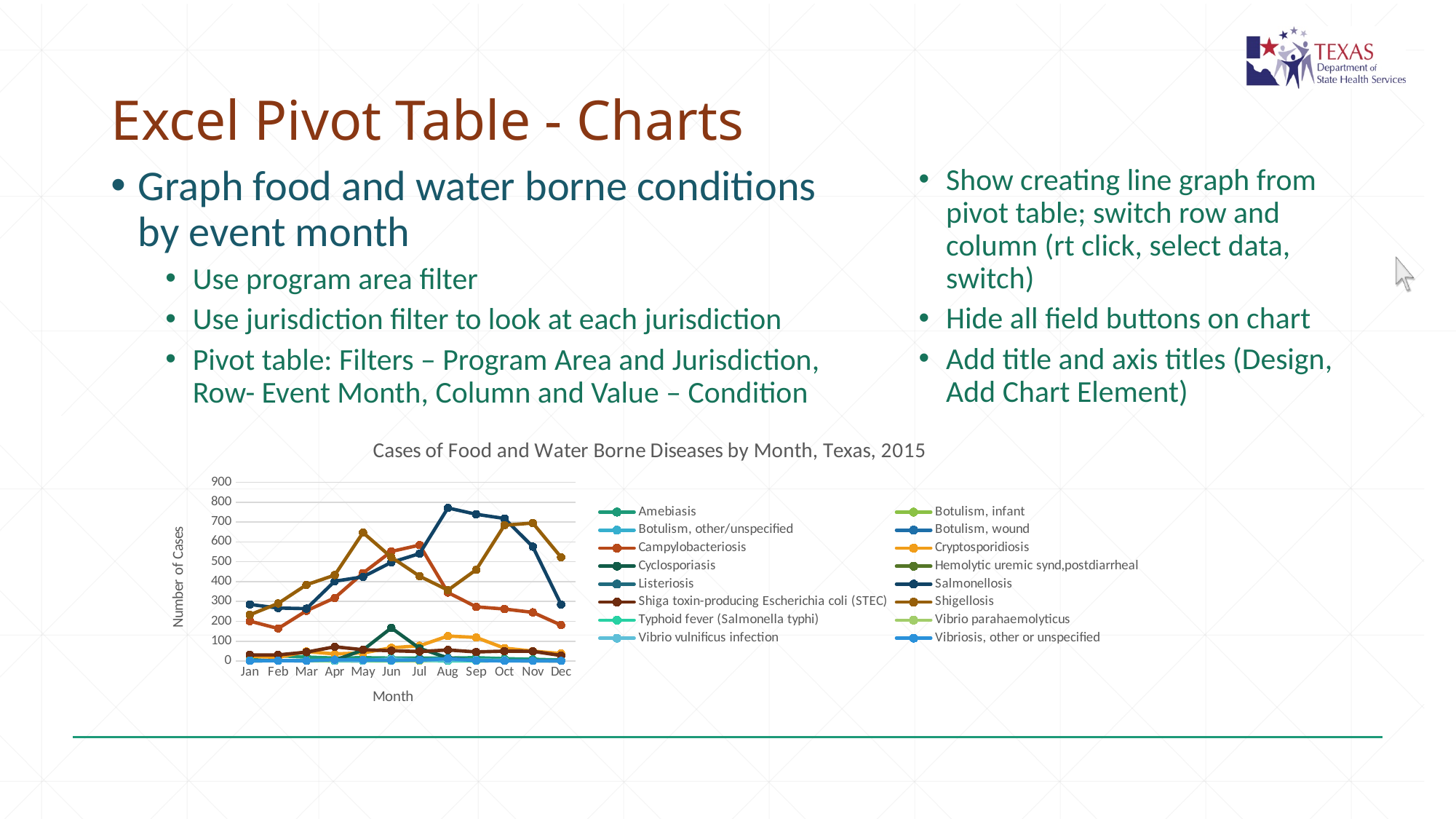
What is the title of the chart? Cases of Food and Water Borne Diseases by Month, Texas, 2015 Is the value for Shigellosis in May greater or less than 600? greater How many months are plotted along the x axis? 12 Which series reaches the highest value on the chart? Salmonellosis Is the value for Salmonellosis in Aug greater or less than 700? greater In which month does Salmonellosis reach its highest value? Aug In May, which is larger: Shigellosis or Salmonellosis? Shigellosis Do Salmonellosis cases rise or fall from Aug to Dec? fall Is the value for Campylobacteriosis in Feb greater or less than 200? less How many series does the chart's legend list? 16 What kind of chart is shown on the slide? line chart What is the label of the vertical axis? Number of Cases